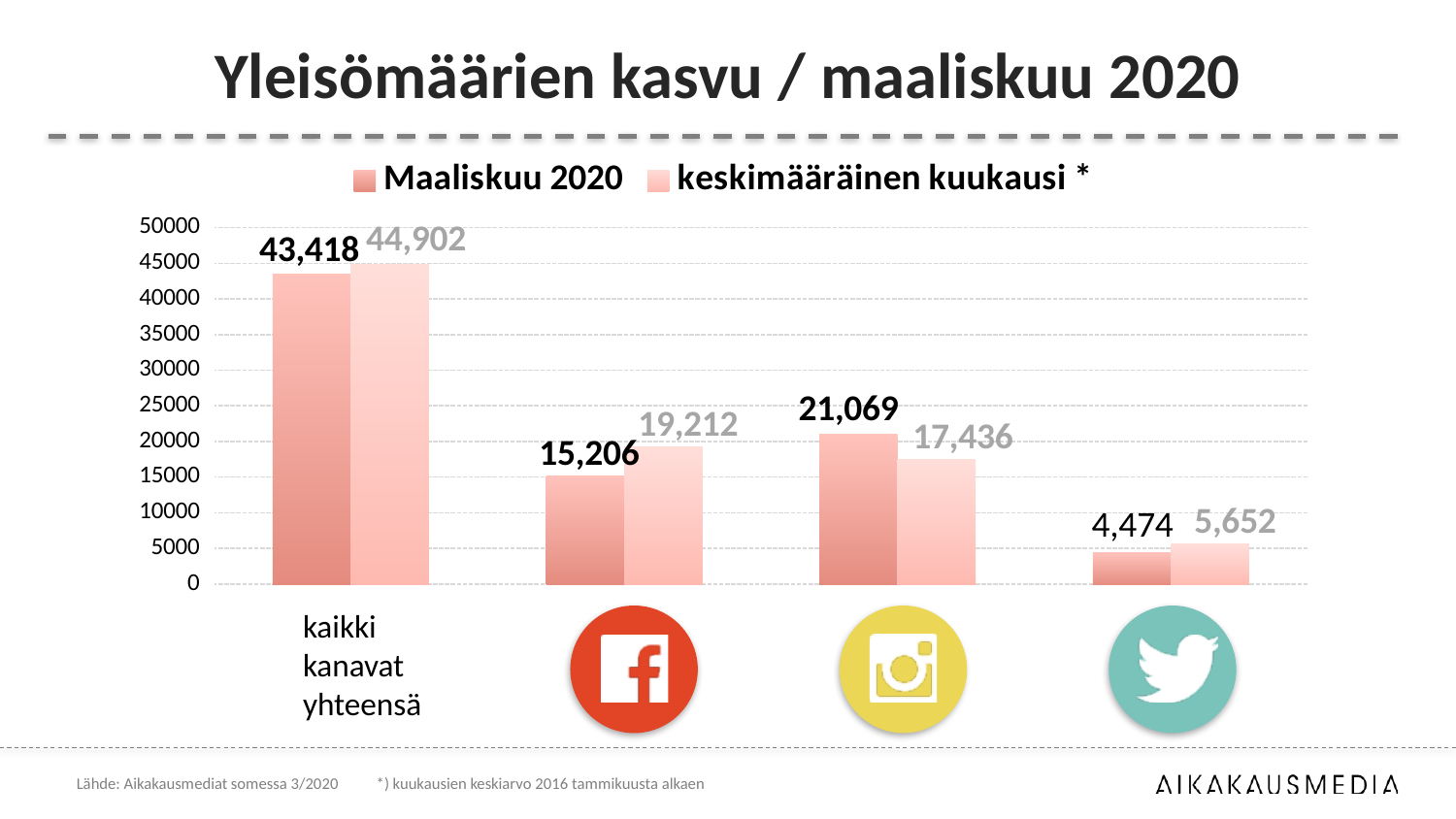
What is the keskimääräinen kuukausi value for the Facebook category? 19,212 Which category has the highest keskimääräinen kuukausi value? kaikki kanavat yhteensä How many categories are shown on the x axis? 4 What is the Maaliskuu 2020 value for kaikki kanavat yhteensä? 43,418 For the Facebook category, which is larger: the Maaliskuu 2020 value or the keskimääräinen kuukausi value? keskimääräinen kuukausi What is the keskimääräinen kuukausi value for the Twitter category? 5,652 How many series does the legend list? 2 Which category has the lowest Maaliskuu 2020 value? Twitter What is the difference between the Maaliskuu 2020 and keskimääräinen kuukausi values for the Instagram category? 3,633 What kind of chart is shown on the slide? bar chart What is the Maaliskuu 2020 value for the Instagram category? 21,069 What is the title of the slide? Yleisömäärien kasvu / maaliskuu 2020